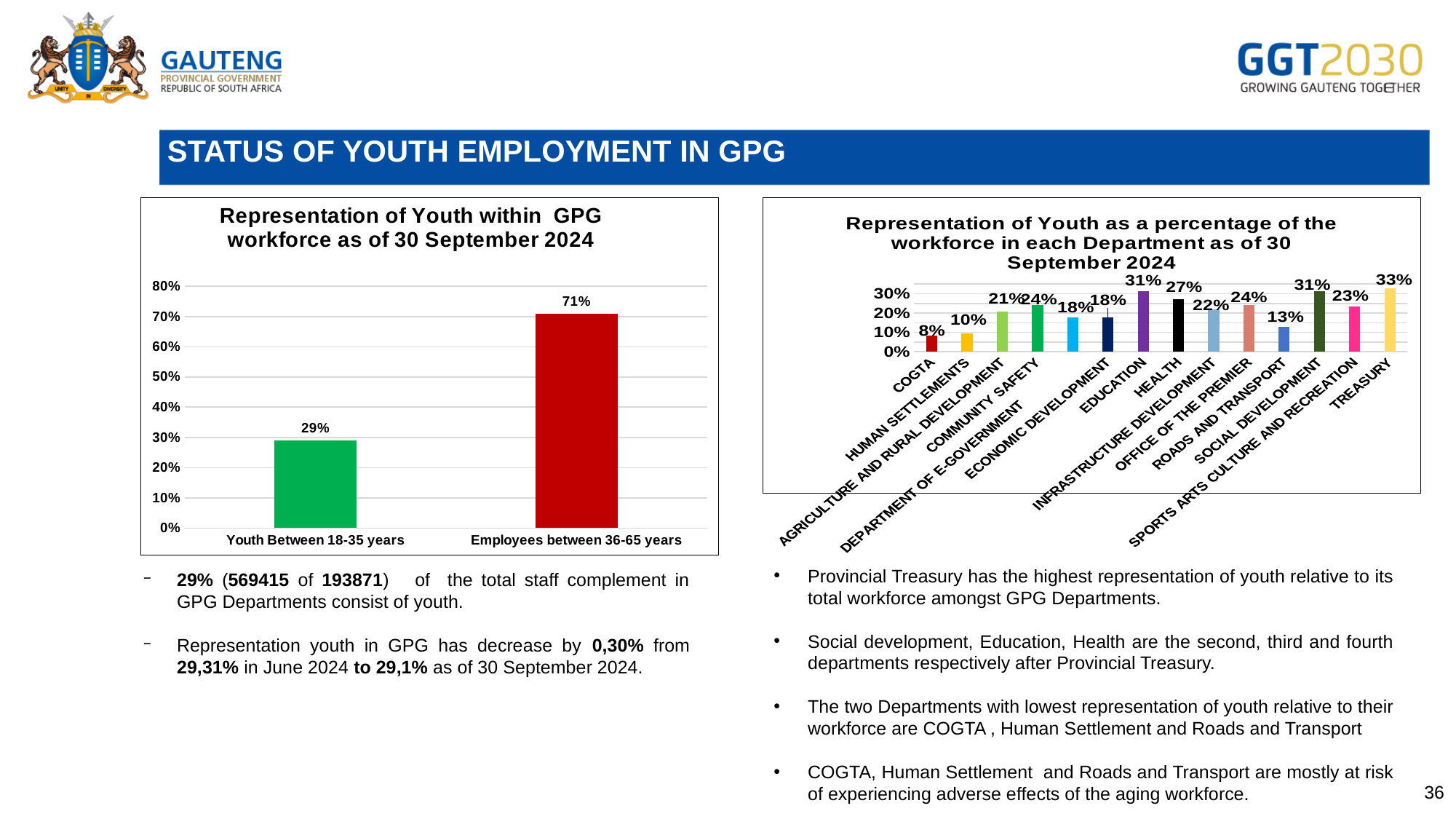
In the chart 'Representation of Youth within GPG workforce as of 30 September 2024', what colour is the bar for Youth Between 18-35 years? Green In the chart 'Representation of Youth as a percentage of the workforce in each Department as of 30 September 2024', which is larger: the value for EDUCATION or the value for HUMAN SETTLEMENTS? EDUCATION In the chart 'Representation of Youth as a percentage of the workforce in each Department as of 30 September 2024', what is the difference between the value for TREASURY and the value for COGTA? 25% In the chart 'Representation of Youth as a percentage of the workforce in each Department as of 30 September 2024', how many departments are shown? 14 In the chart 'Representation of Youth as a percentage of the workforce in each Department as of 30 September 2024', which department has the lowest value? COGTA In the chart 'Representation of Youth as a percentage of the workforce in each Department as of 30 September 2024', which department has the highest value? TREASURY In the chart 'Representation of Youth as a percentage of the workforce in each Department as of 30 September 2024', what is the value for HEALTH? 27% In the chart 'Representation of Youth within GPG workforce as of 30 September 2024', what is the value for Youth Between 18-35 years? 29% In the chart 'Representation of Youth within GPG workforce as of 30 September 2024', what is the value for Employees between 36-65 years? 71% In the chart 'Representation of Youth as a percentage of the workforce in each Department as of 30 September 2024', what is the value for ROADS AND TRANSPORT? 13% What kind of chart is 'Representation of Youth within GPG workforce as of 30 September 2024'? Bar chart In the chart 'Representation of Youth within GPG workforce as of 30 September 2024', what is the difference between the value for Employees between 36-65 years and the value for Youth Between 18-35 years? 42%